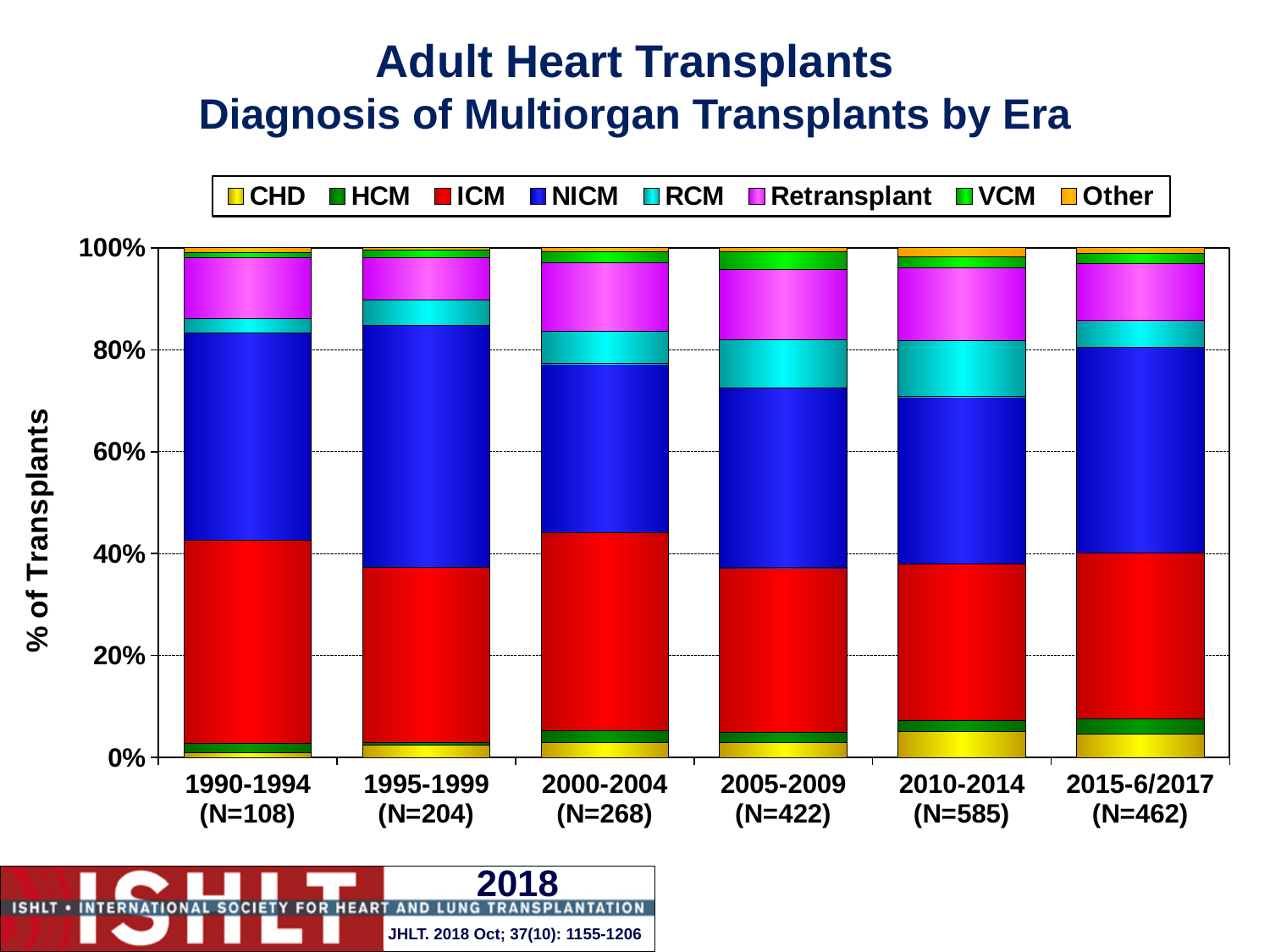
Which is larger, the RCM share in 2010-2014 or in 1990-1994? 2010-2014 Is the NICM share for 1995-1999 greater or less than 40%? greater How many series does the legend list? 8 What is the label on the y axis? % of Transplants Is the ICM share for 2005-2009 greater or less than 40%? less How many eras (categories) are shown along the x axis? 6 What is the N value shown for the 1990-1994 era? N=108 Which era has the largest NICM share? 1995-1999 What is the N value shown for the 2010-2014 era? N=585 Which is larger, the Retransplant share in 2005-2009 or in 1995-1999? 2005-2009 What does each full stacked bar total? 100% What kind of chart is shown on the slide? Stacked bar chart